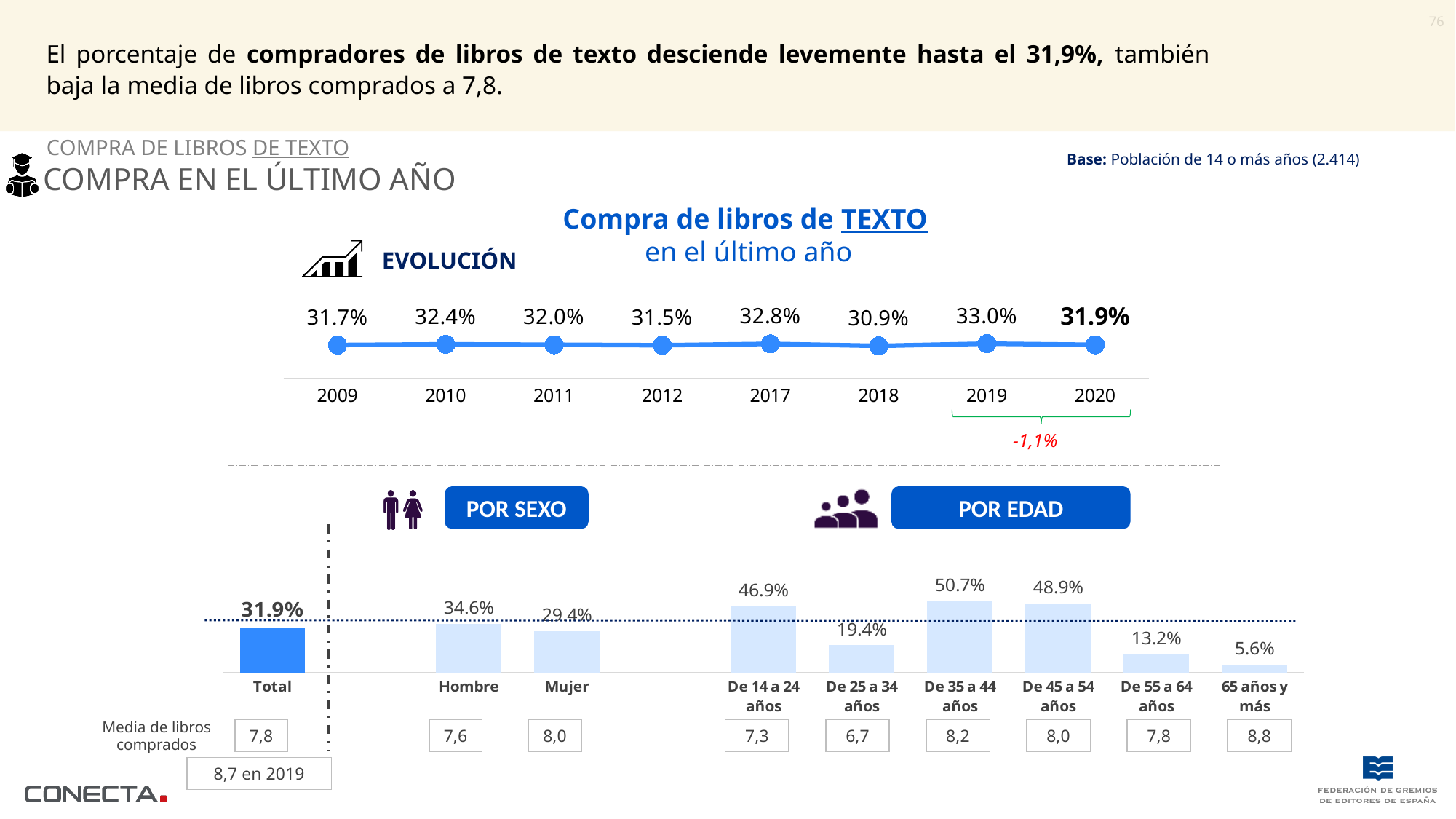
What kind of chart is the POR SEXO / POR EDAD chart at the bottom? Bar chart What kind of chart is the EVOLUCIÓN chart? Line chart In the EVOLUCIÓN line chart, which year has the lowest value? 2018 In the EVOLUCIÓN line chart, what is the value for 2020? 31.9% In the bar chart at the bottom, which age group has the highest value? De 35 a 44 años In the bar chart at the bottom, which is larger, De 14 a 24 años or De 45 a 54 años? De 45 a 54 años In the bar chart at the bottom, what is the value for Mujer? 29.4% In the bar chart at the bottom, which category has the lowest value? 65 años y más In the EVOLUCIÓN line chart, what is the difference between the 2019 and 2020 values? 1.1% In the bar chart at the bottom, what is the difference between Hombre and Mujer? 5.2% In the EVOLUCIÓN line chart, how many years are plotted? 8 In the EVOLUCIÓN line chart, which year has the highest value? 2019